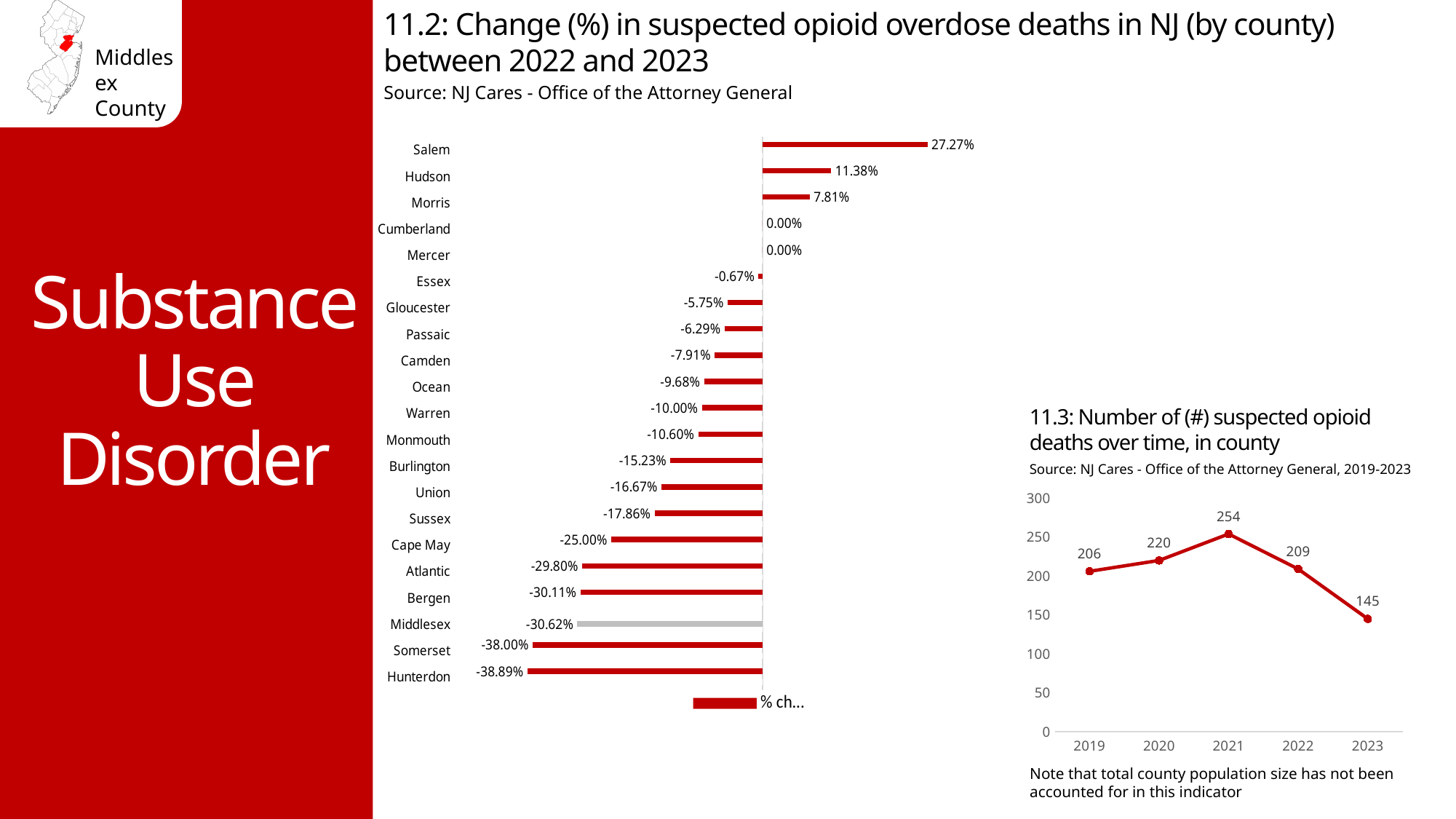
In the chart '11.3: Number of (#) suspected opioid deaths over time, in county', what is the difference between the values for 2022 and 2023? 64 What kind of chart is '11.2: Change (%) in suspected opioid overdose deaths in NJ (by county) between 2022 and 2023'? Bar chart In the chart '11.2: Change (%) in suspected opioid overdose deaths in NJ (by county) between 2022 and 2023', which county has the highest value? Salem In the chart '11.2: Change (%) in suspected opioid overdose deaths in NJ (by county) between 2022 and 2023', which county has the lowest value? Hunterdon In the chart '11.2: Change (%) in suspected opioid overdose deaths in NJ (by county) between 2022 and 2023', what is the value for Middlesex? -30.62% What kind of chart is '11.3: Number of (#) suspected opioid deaths over time, in county'? Line chart In the chart '11.2: Change (%) in suspected opioid overdose deaths in NJ (by county) between 2022 and 2023', which is larger, the value for Atlantic or the value for Bergen? Atlantic In the chart '11.2: Change (%) in suspected opioid overdose deaths in NJ (by county) between 2022 and 2023', what is the difference between the values for Salem and Hudson? 15.89% In the chart '11.3: Number of (#) suspected opioid deaths over time, in county', which year has the lowest value? 2023 In the chart '11.3: Number of (#) suspected opioid deaths over time, in county', what is the value for 2021? 254 In the chart '11.2: Change (%) in suspected opioid overdose deaths in NJ (by county) between 2022 and 2023', how many counties are shown? 21 In the chart '11.2: Change (%) in suspected opioid overdose deaths in NJ (by county) between 2022 and 2023', what is the value for Hudson? 11.38%